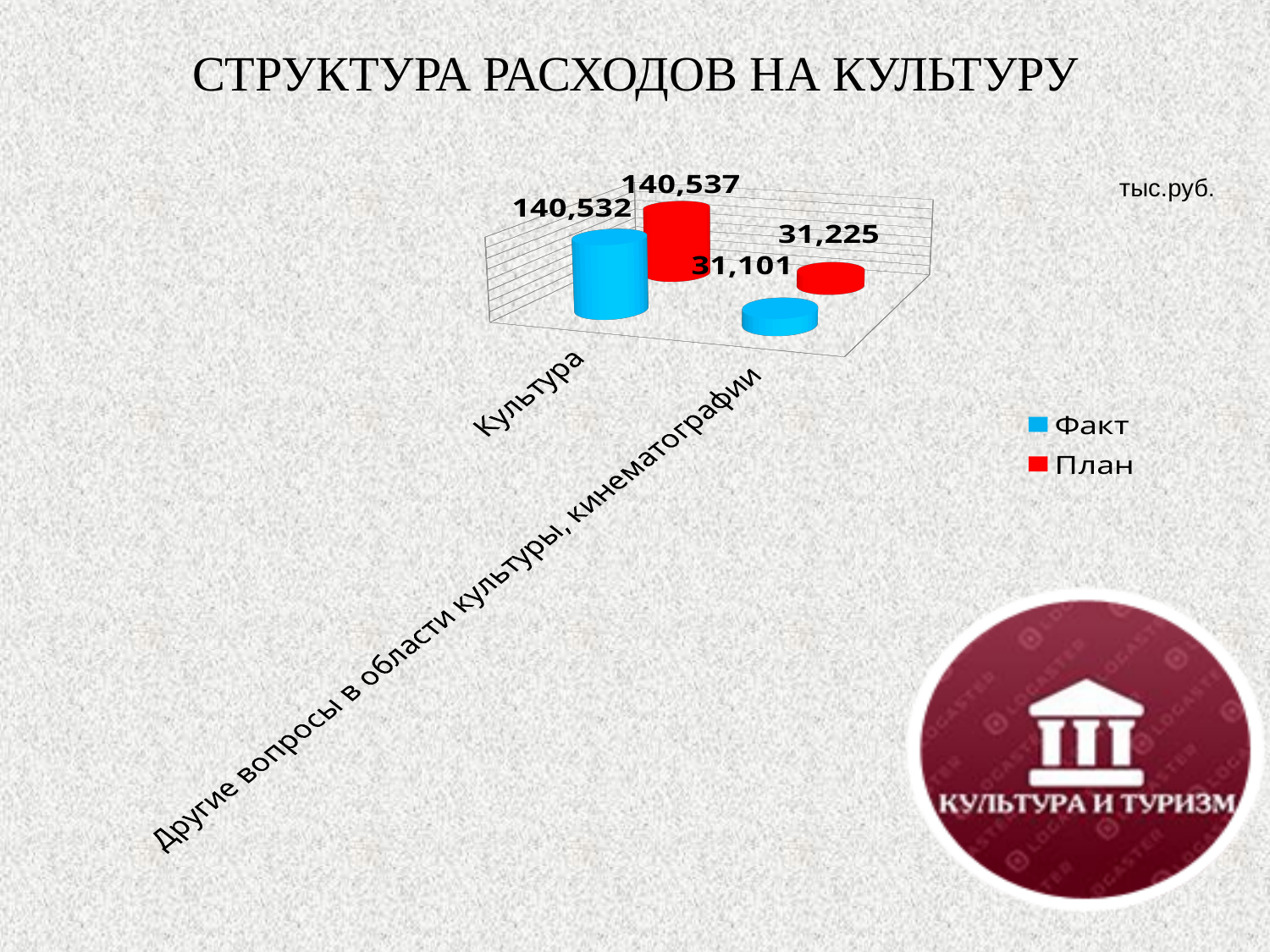
What kind of chart is shown on the slide? Bar chart Which category has the higher Факт value? Культура What is the Факт value for Культура? 140,532 Which category has the lowest План value? Другие вопросы в области культуры, кинематографии How many categories are shown on the chart? 2 What is the title of the slide? СТРУКТУРА РАСХОДОВ НА КУЛЬТУРУ Which colour represents the План series in the legend? Red What is the План value for Другие вопросы в области культуры, кинематографии? 31,225 How many series does the legend list? 2 For Другие вопросы в области культуры, кинематографии, which is larger: Факт or План? План What is the Факт value for Другие вопросы в области культуры, кинематографии? 31,101 What is the План value for Культура? 140,537